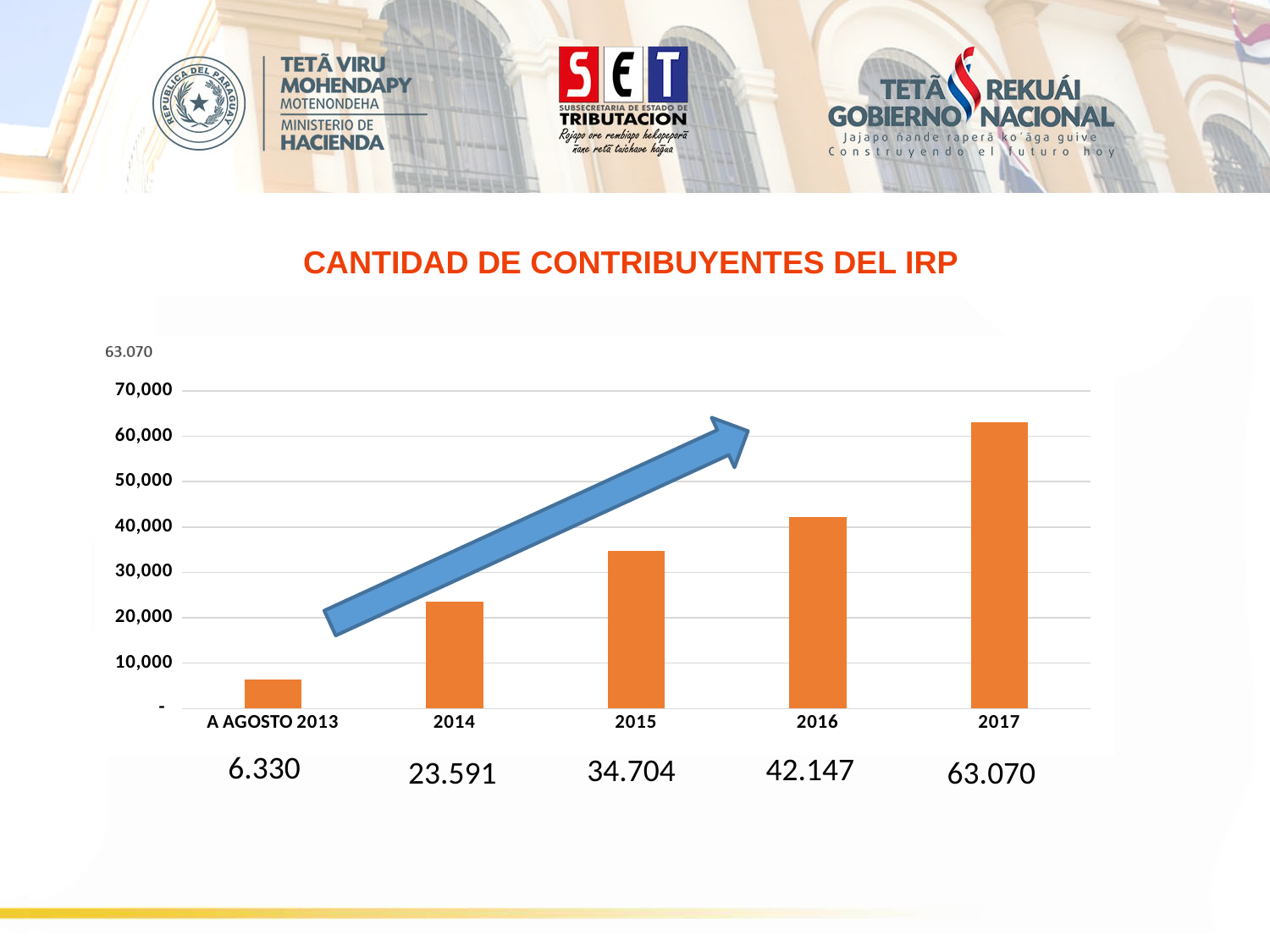
What kind of chart is shown on the slide? bar chart How many categories are shown on the x axis? 5 What is the value for 2017? 63.070 Which category has the lowest value? A AGOSTO 2013 Which category has the highest value? 2017 What is the difference between the values for 2014 and A AGOSTO 2013? 17.261 What is the value for A AGOSTO 2013? 6.330 What is the difference between the values for 2017 and 2016? 20.923 Which is larger, the value for 2015 or the value for 2016? 2016 Is the value for 2016 greater or less than 40,000? greater What is the value for 2015? 34.704 Do the values rise or fall from A AGOSTO 2013 to 2017? rise